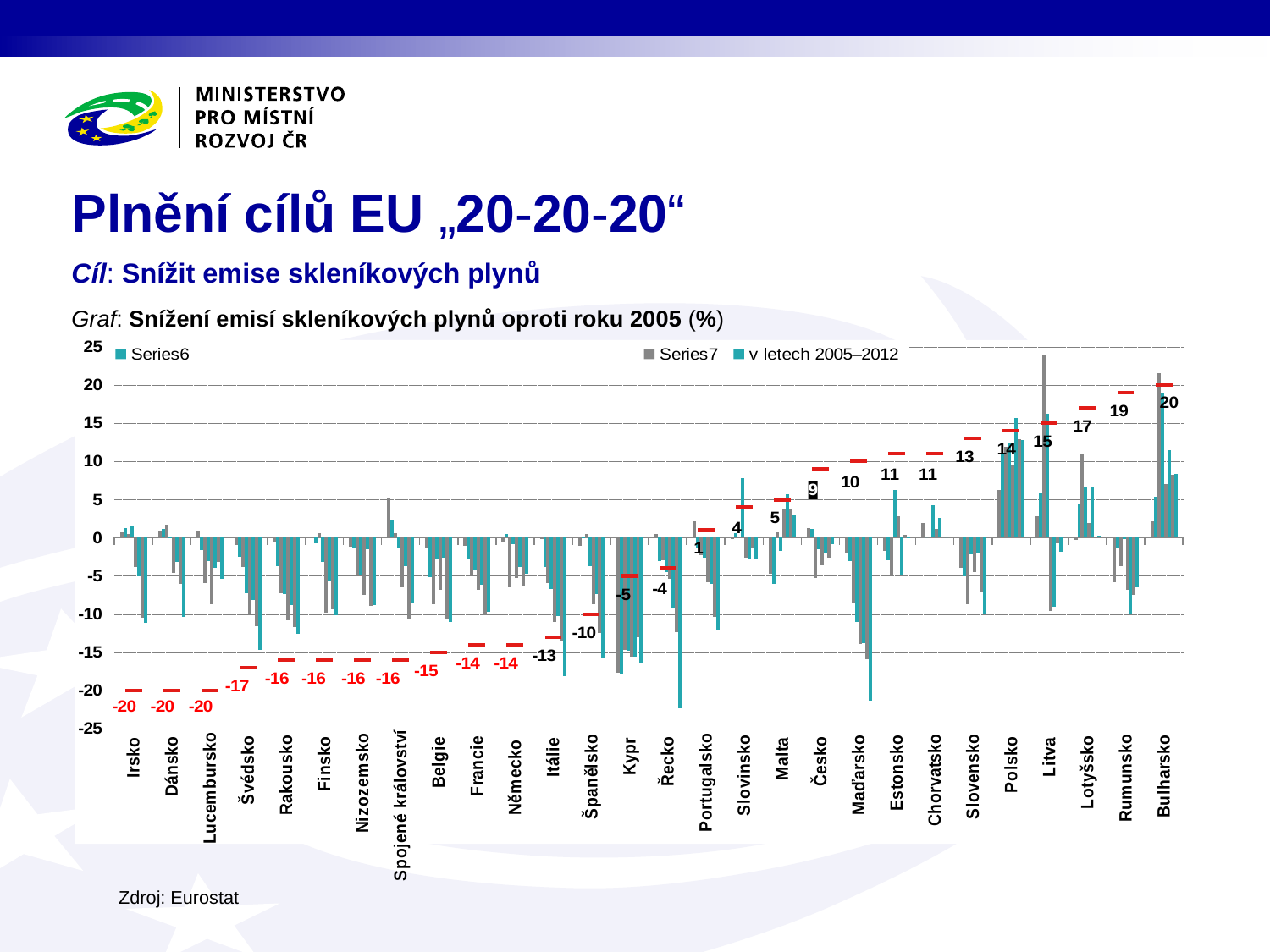
Do the labelled target values rise or fall from left to right along the x axis? rise How many countries are shown on the x axis? 28 Which country has the highest labelled target value? Bulharsko What is the labelled target value for Belgie? -15 What kind of chart is shown on the slide? bar chart What is the difference between the labelled target values for Rumunsko and Lotyšsko? 2 What is the labelled target value for Bulharsko? 20 What is the labelled target value for Irsko? -20 What source is cited below the chart? Eurostat How many series does the legend list? 3 What is the labelled target value for Česko? 9 Which has the larger labelled target value, Polsko or Slovensko? Polsko